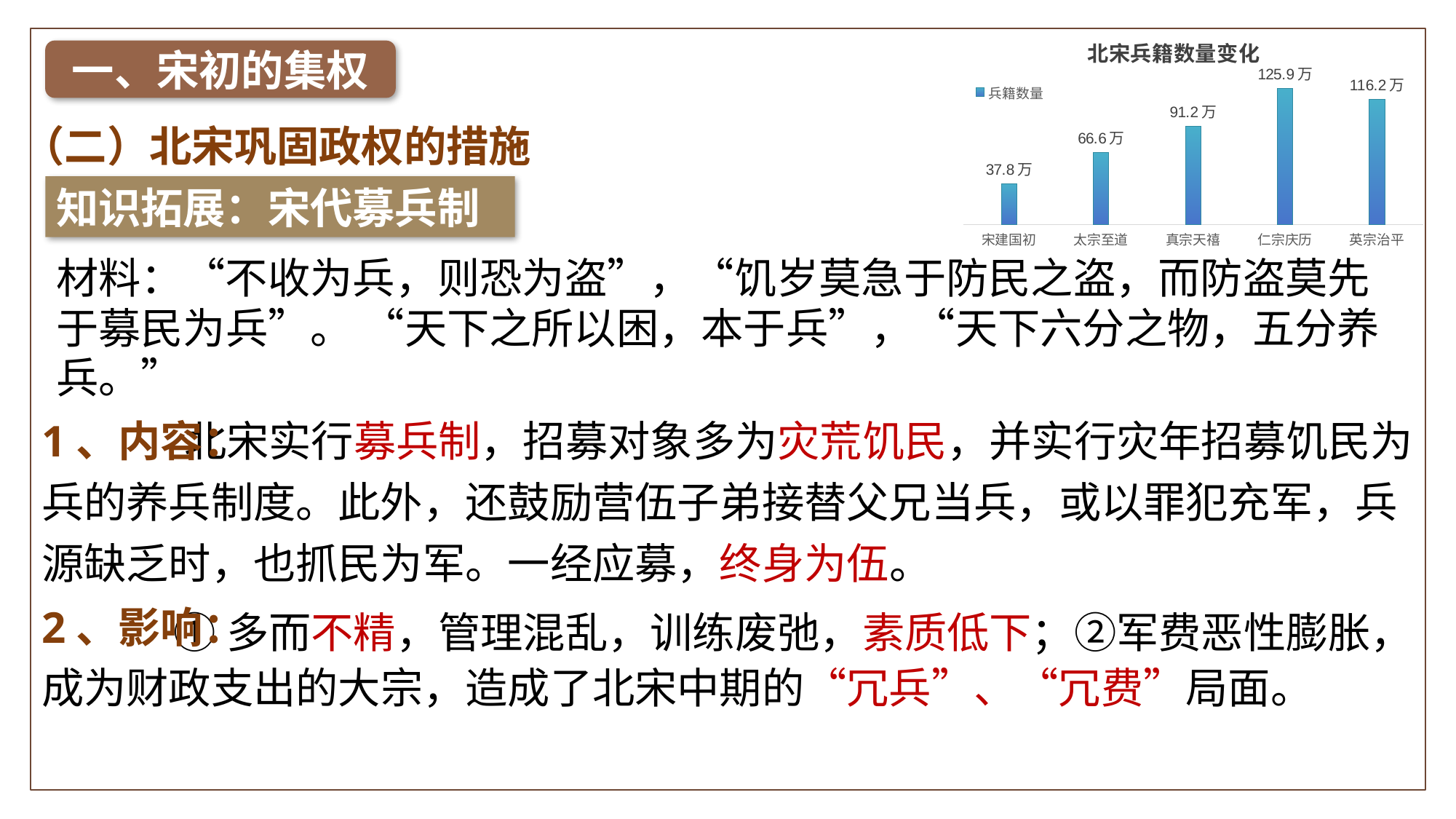
What kind of chart is 北宋兵籍数量变化? Bar chart Which is larger in the chart 北宋兵籍数量变化, the value for 太宗至道 or the value for 真宗天禧? 真宗天禧 How many series does the legend of the chart 北宋兵籍数量变化 list? 1 What is the difference between the values for 仁宗庆历 and 英宗治平 in the chart 北宋兵籍数量变化? 9.7万 What is the value for 英宗治平 in the chart 北宋兵籍数量变化? 116.2万 How many periods (categories) are shown in the chart 北宋兵籍数量变化? 5 What is the difference between the values for 真宗天禧 and 太宗至道 in the chart 北宋兵籍数量变化? 24.6万 Which period has the highest value in the chart 北宋兵籍数量变化? 仁宗庆历 What is the value for 仁宗庆历 in the chart 北宋兵籍数量变化? 125.9万 Which period has the lowest value in the chart 北宋兵籍数量变化? 宋建国初 What is the value for 宋建国初 in the chart 北宋兵籍数量变化? 37.8万 What is the legend entry shown in the chart 北宋兵籍数量变化? 兵籍数量